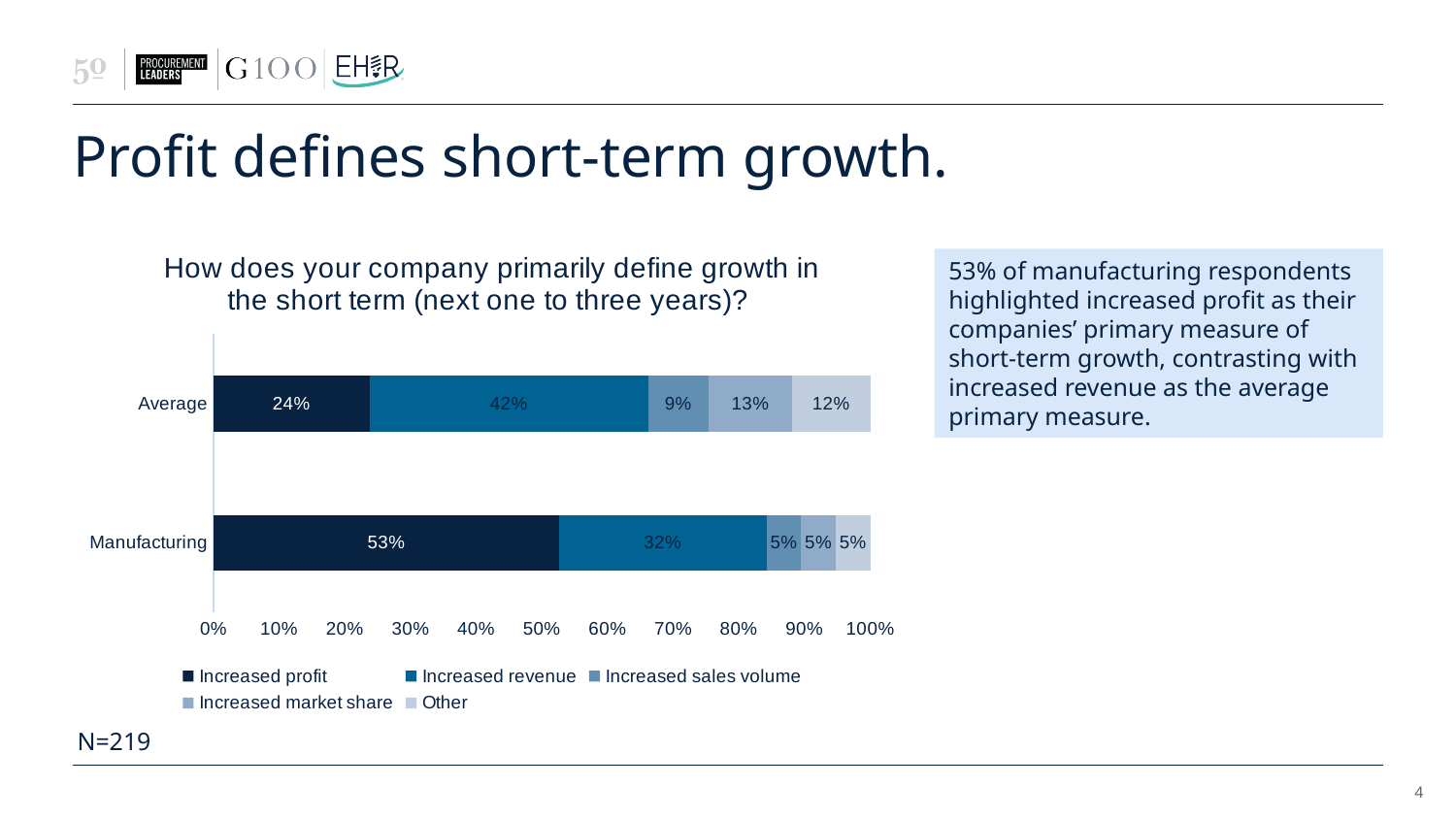
What is the Increased sales volume value for Manufacturing? 5% What is the Increased market share value for the Average category? 13% What is the total of the stacked bar for Manufacturing? 100% What is the difference between the Increased profit values for Manufacturing and Average? 29 percentage points Which series has the smallest share for the Average category? Increased sales volume What is the Increased revenue value for the Average category? 42% How many categories are shown on the y axis? 2 Which is larger: the Increased revenue value for Average or for Manufacturing? Average What kind of chart is shown on the slide? Stacked bar chart What percentage of Manufacturing respondents chose Increased profit? 53% Which series has the largest share for the Average category? Increased revenue How many series does the legend list? 5